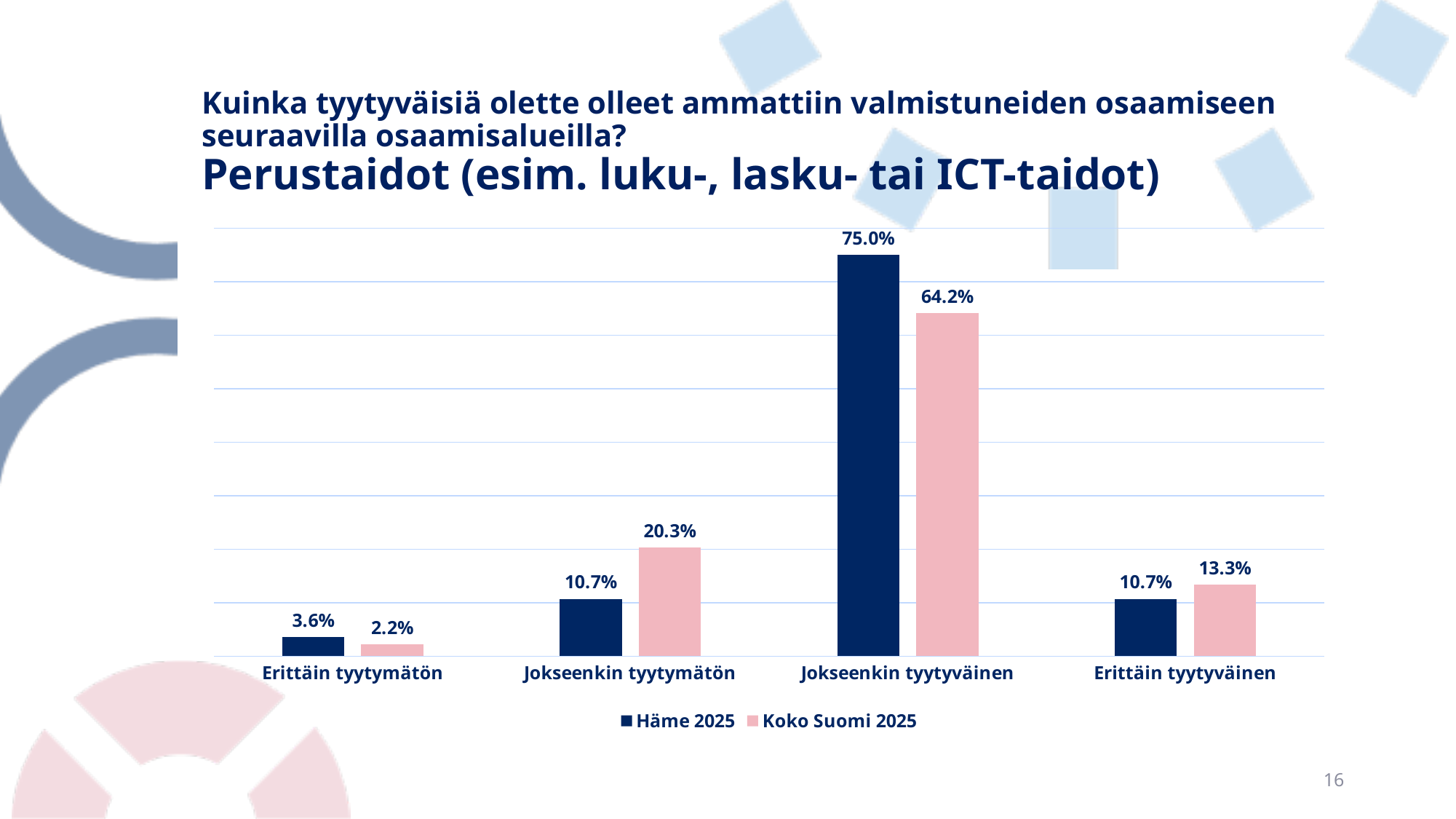
Which series is shown in dark blue in the legend? Häme 2025 In the Erittäin tyytyväinen category, which series has the larger value, Häme 2025 or Koko Suomi 2025? Koko Suomi 2025 What is the difference between Häme 2025 and Koko Suomi 2025 in the Jokseenkin tyytyväinen category? 10.8% How many series does the legend list? 2 What is the difference between Koko Suomi 2025 and Häme 2025 in the Jokseenkin tyytymätön category? 9.6% Which category has the lowest value for Koko Suomi 2025? Erittäin tyytymätön What is the value for Koko Suomi 2025 in the Jokseenkin tyytymätön category? 20.3% What is the value for Häme 2025 in the Jokseenkin tyytyväinen category? 75.0% What kind of chart is shown on the slide? Bar chart What is the value for Koko Suomi 2025 in the Erittäin tyytymätön category? 2.2% Which category has the highest value for Häme 2025? Jokseenkin tyytyväinen How many categories are shown on the x axis? 4